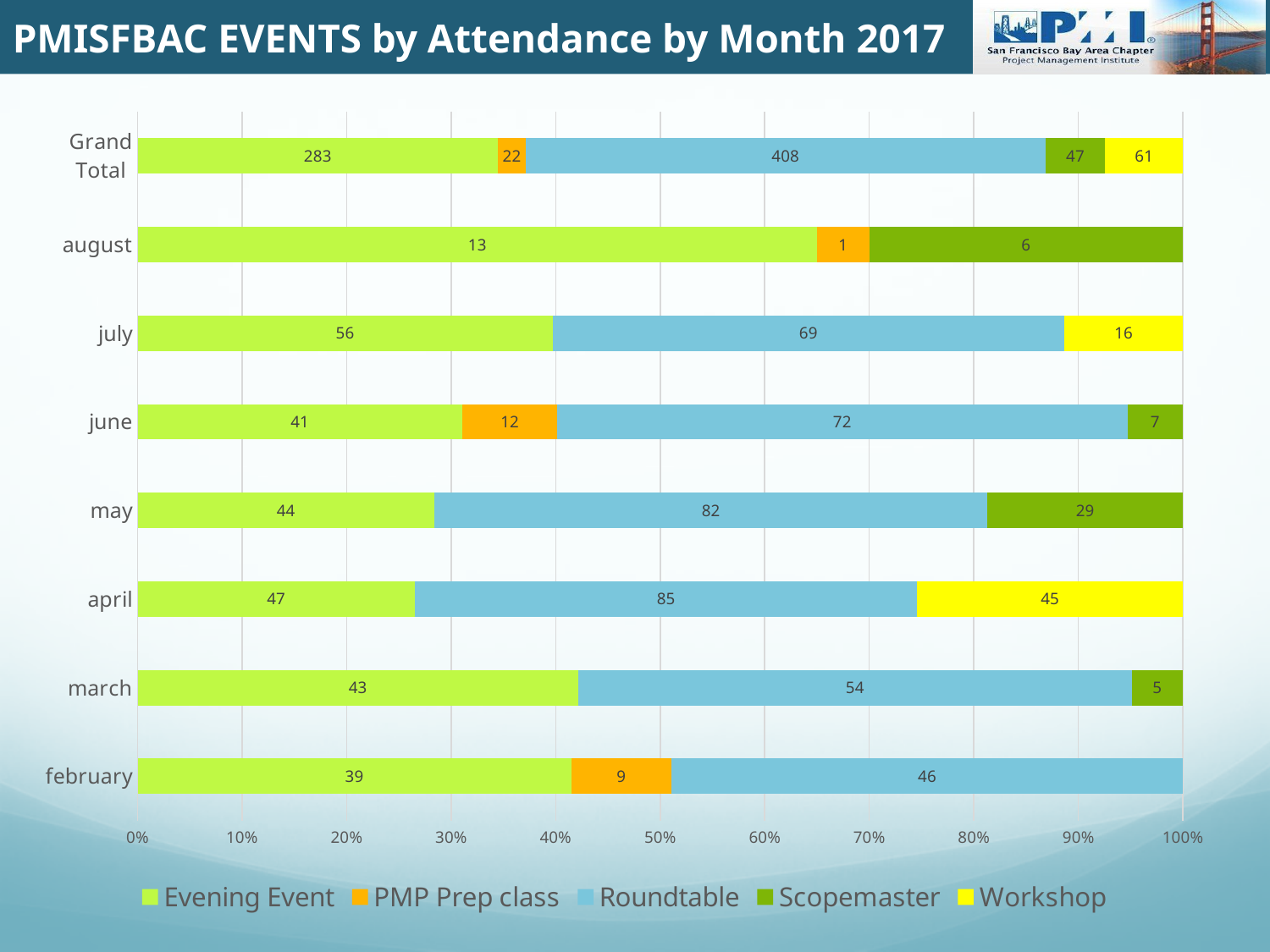
What is the Roundtable attendance for april? 85 Which month has the lowest Evening Event attendance? august What is the Workshop attendance in the Grand Total bar? 61 How many month categories are shown on the chart, excluding Grand Total? 7 Which month has the highest Roundtable attendance? april Which is larger, the Scopemaster attendance in may or in june? may What kind of chart is shown on the slide? 100% stacked bar chart What is the PMP Prep class attendance for june? 12 What is the total attendance for february across all series? 94 How many series does the legend list? 5 What is the difference between the Roundtable attendance in may and in march? 28 What is the Evening Event attendance for july? 56